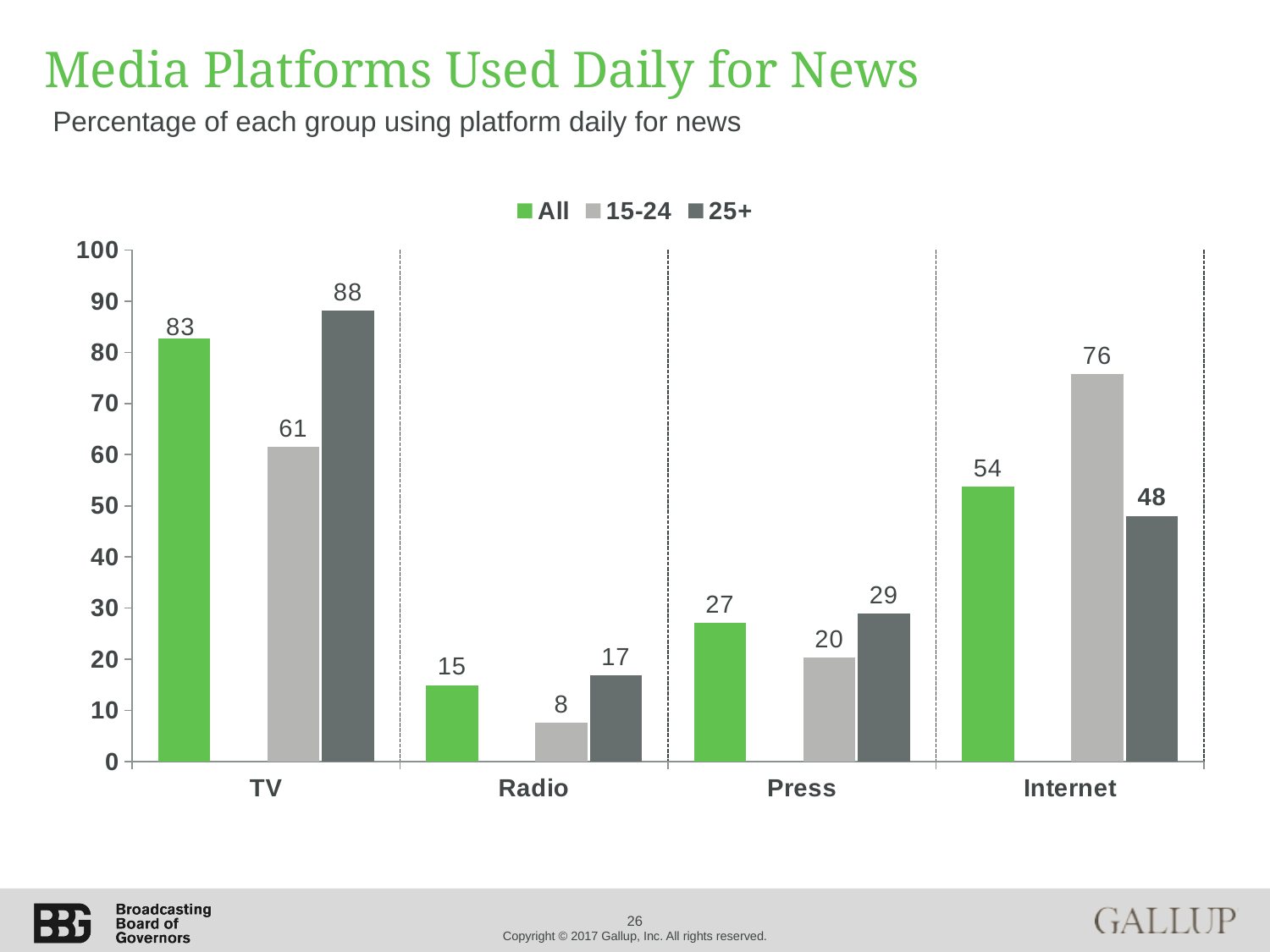
What is the value for the 25+ group for TV? 88 How many platforms are shown on the x axis? 4 What is the difference between the 15-24 and 25+ values for Internet? 28 What kind of chart is shown on the slide? Bar chart What is the value for the 15-24 group for Internet? 76 What is the difference between the 25+ and 15-24 values for TV? 27 How many series does the legend list? 3 For Press, which group has the larger value, All or 25+? 25+ Which platform has the lowest value for the 15-24 group? Radio Which platform has the highest value for the All group? TV What is the title of the chart? Media Platforms Used Daily for News What is the value for the All group for Radio? 15